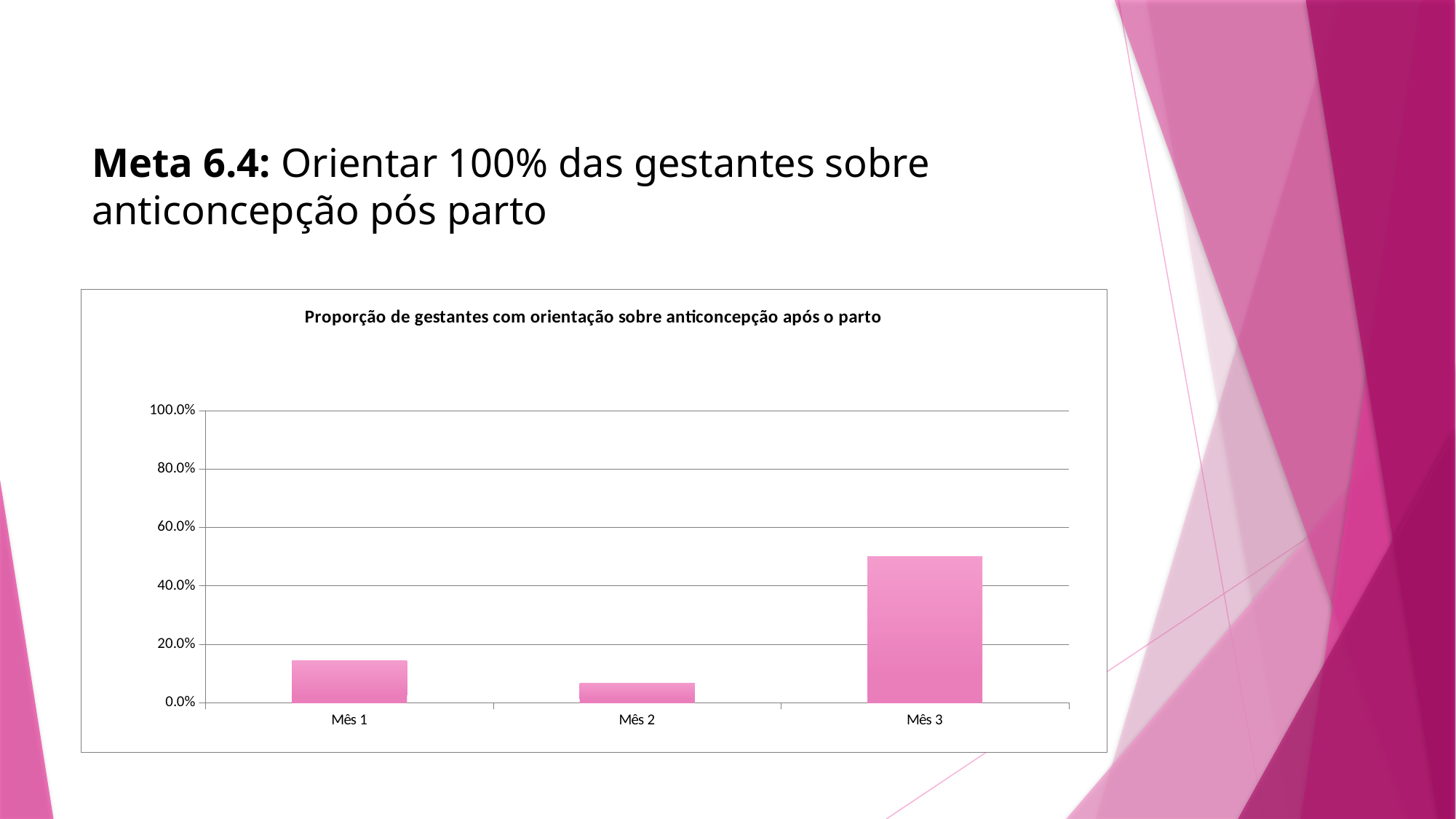
Which is larger, the value for Mês 1 or the value for Mês 2? Mês 1 Which month has the lowest value in the chart? Mês 2 Is the value for Mês 2 greater or less than 20.0%? less Is the value for Mês 3 greater or less than 60.0%? less Does the value rise or fall from Mês 2 to Mês 3? rise Is the value for Mês 1 greater or less than 20.0%? less What is the title of the chart? Proporção de gestantes com orientação sobre anticoncepção após o parto How many categories are shown on the x axis of the chart? 3 Does the value rise or fall from Mês 1 to Mês 2? fall Which month has the highest value in the chart? Mês 3 What kind of chart is shown on the slide? bar chart